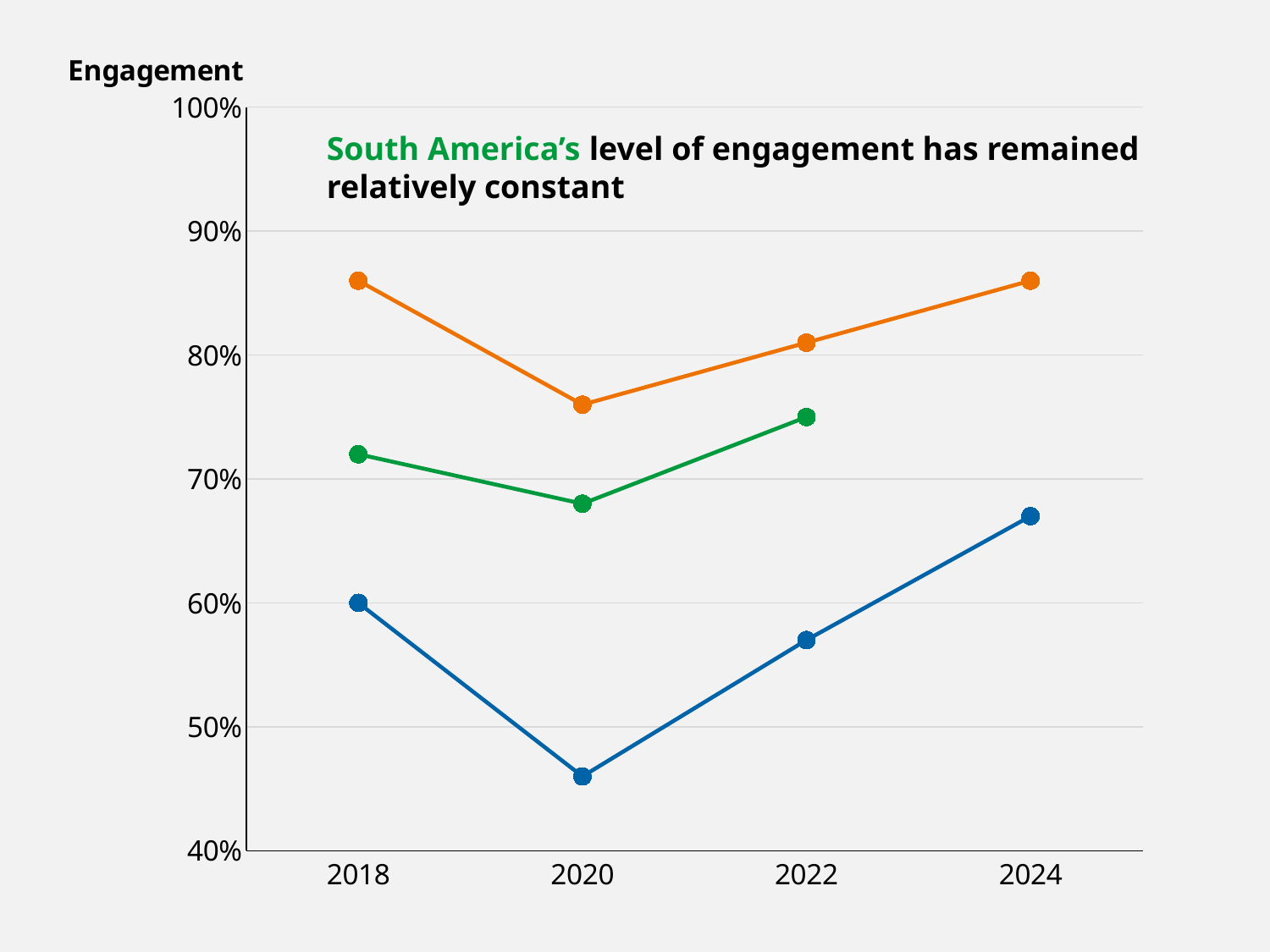
In 2018, which line has the higher engagement value, the orange line or the green line? orange line Is the blue line's value for 2024 greater or less than 60%? greater What is the title of the vertical axis of the chart? Engagement Is South America's engagement value for 2020 greater or less than 70%? less How many lines are plotted on the chart? 3 In which year does the blue line reach its lowest value? 2020 How many years are shown on the x axis of the chart? 4 What kind of chart is shown on the slide? line chart Is the orange line's value for 2020 greater or less than 80%? less Does the blue line rise or fall from 2020 to 2024? rise